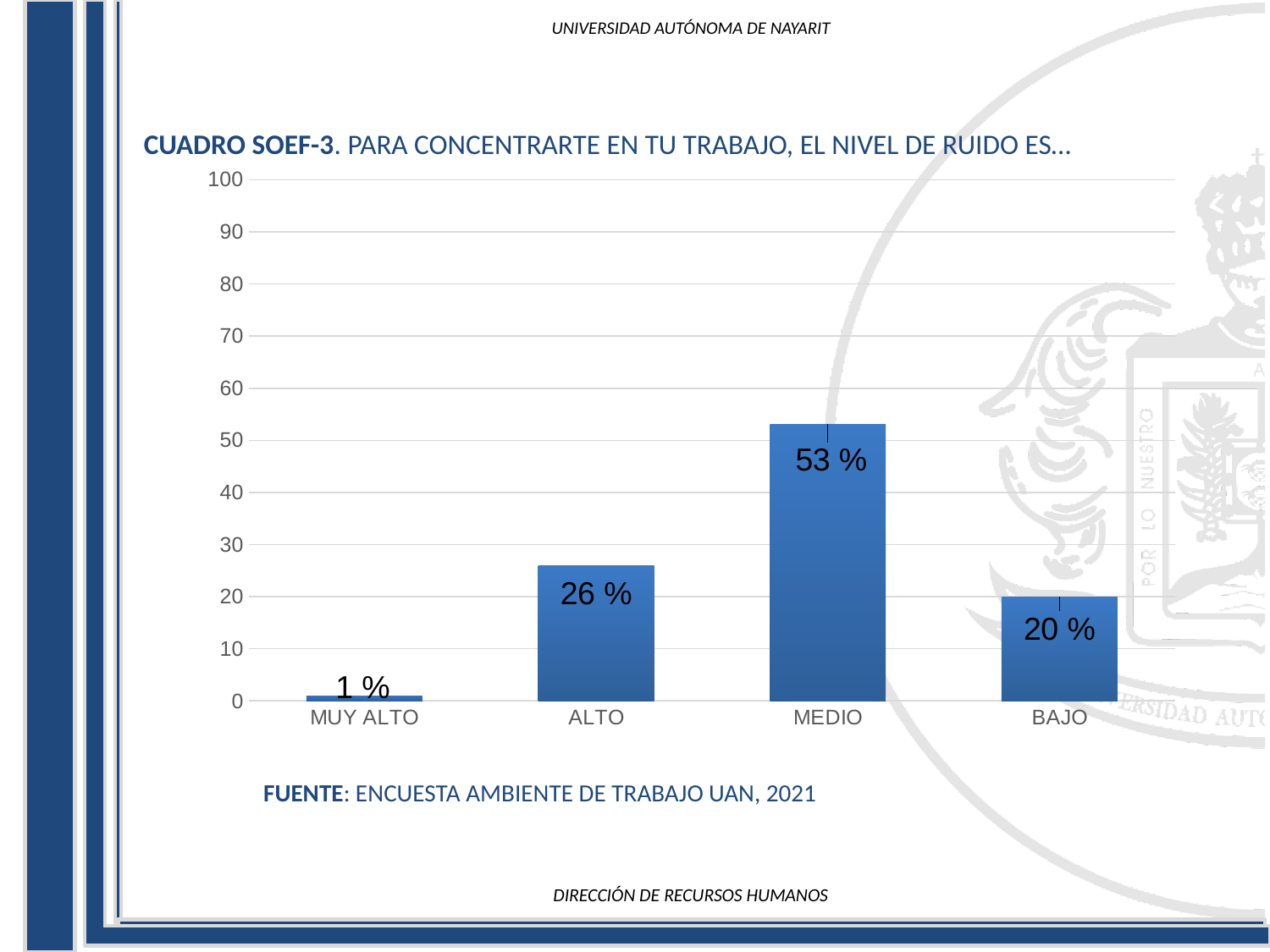
What kind of chart is shown on the slide? bar chart Which category has the highest value? MEDIO What is the value for ALTO? 26 % What is the difference between the values for MEDIO and ALTO? 27 % What is the value for BAJO? 20 % Which category has the lowest value? MUY ALTO How many categories are shown on the x axis? 4 Which is larger, the value for ALTO or the value for BAJO? ALTO Is the value for MEDIO greater or less than 50? greater What is the value for MEDIO? 53 % What is the value for MUY ALTO? 1 % What is the source cited below the chart? ENCUESTA AMBIENTE DE TRABAJO UAN, 2021